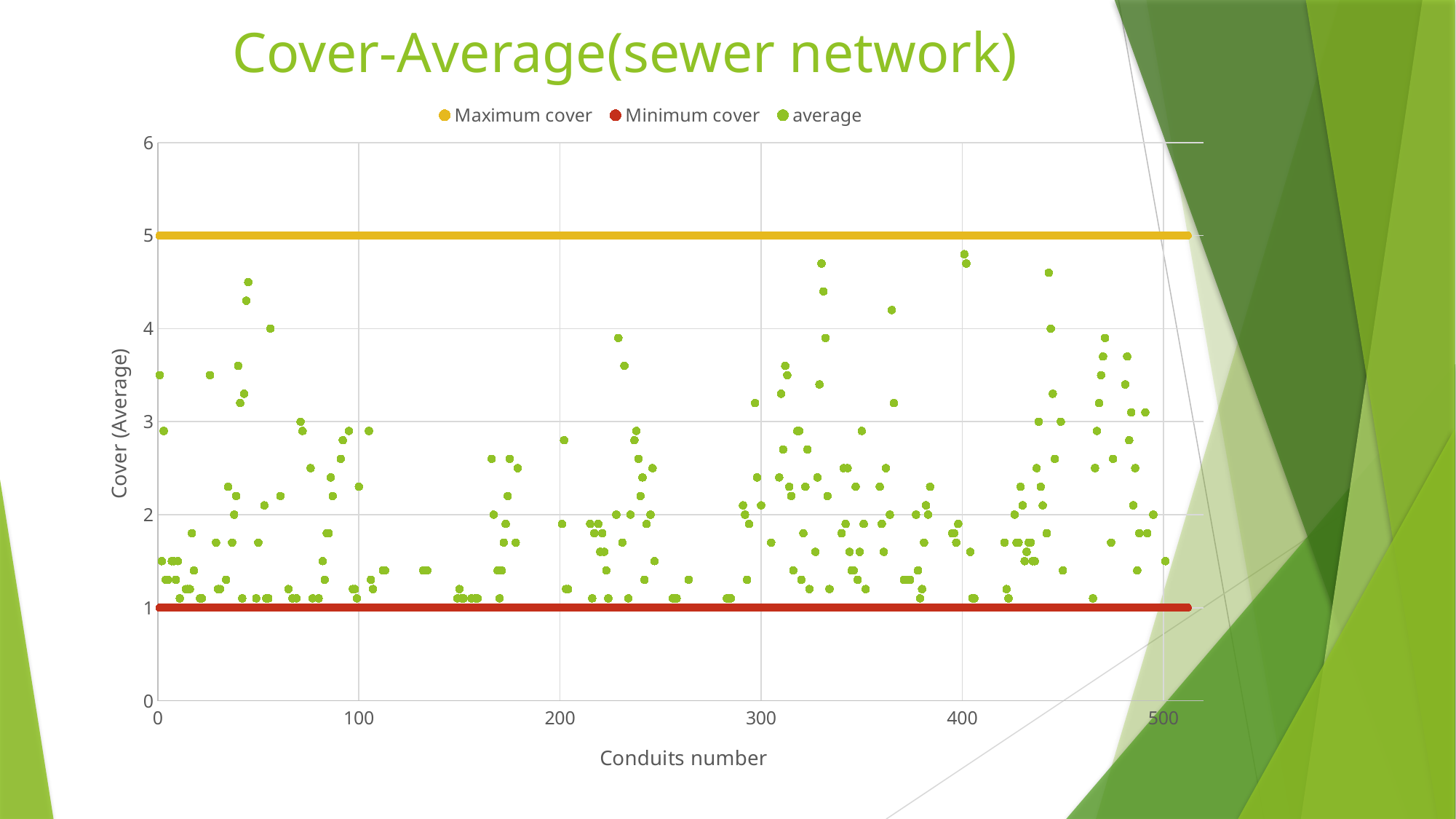
What value does the Minimum cover series sit at on the y axis? 1 How many series does the legend list? 3 What value does the Maximum cover series sit at on the y axis? 5 Is the Minimum cover value greater or less than 2? less Which is larger, the Maximum cover value or the Minimum cover value? Maximum cover What is the title of the chart? Cover-Average(sewer network) Does the Maximum cover series rise, fall, or stay constant along the x axis? Stays constant What kind of chart is shown on the slide? Scatter chart Is the highest average point greater or less than 4? greater Is the highest average point greater or less than 5? less What is the difference between the Maximum cover value and the Minimum cover value? 4 What is the label of the x axis? Conduits number